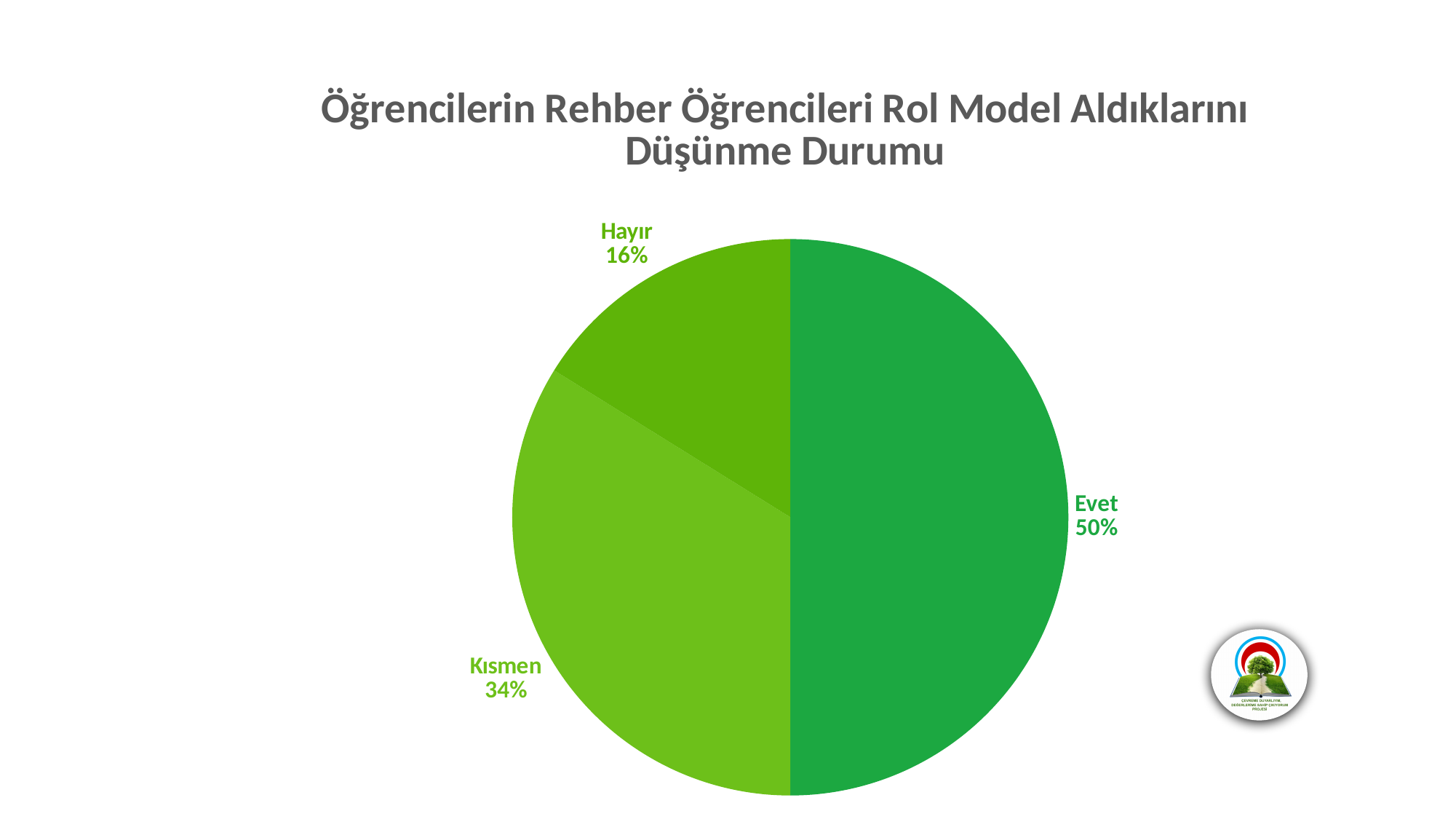
What is the difference in percentage points between Kısmen and Hayır? 18 Which is larger, the share for Kısmen or the share for Hayır? Kısmen What percentage of the pie is labelled Hayır? 16% What percentage of the pie is labelled Evet? 50% What percentage of the pie is labelled Kısmen? 34% How many slices does the pie chart have? 3 What is the difference in percentage points between Evet and Kısmen? 16 What share of the pie does the Evet slice represent? 50% What type of chart is shown on the slide? Pie chart Which category has the smallest share of the pie? Hayır Which category has the largest share of the pie? Evet What is the title of the chart? Öğrencilerin Rehber Öğrencileri Rol Model Aldıklarını Düşünme Durumu